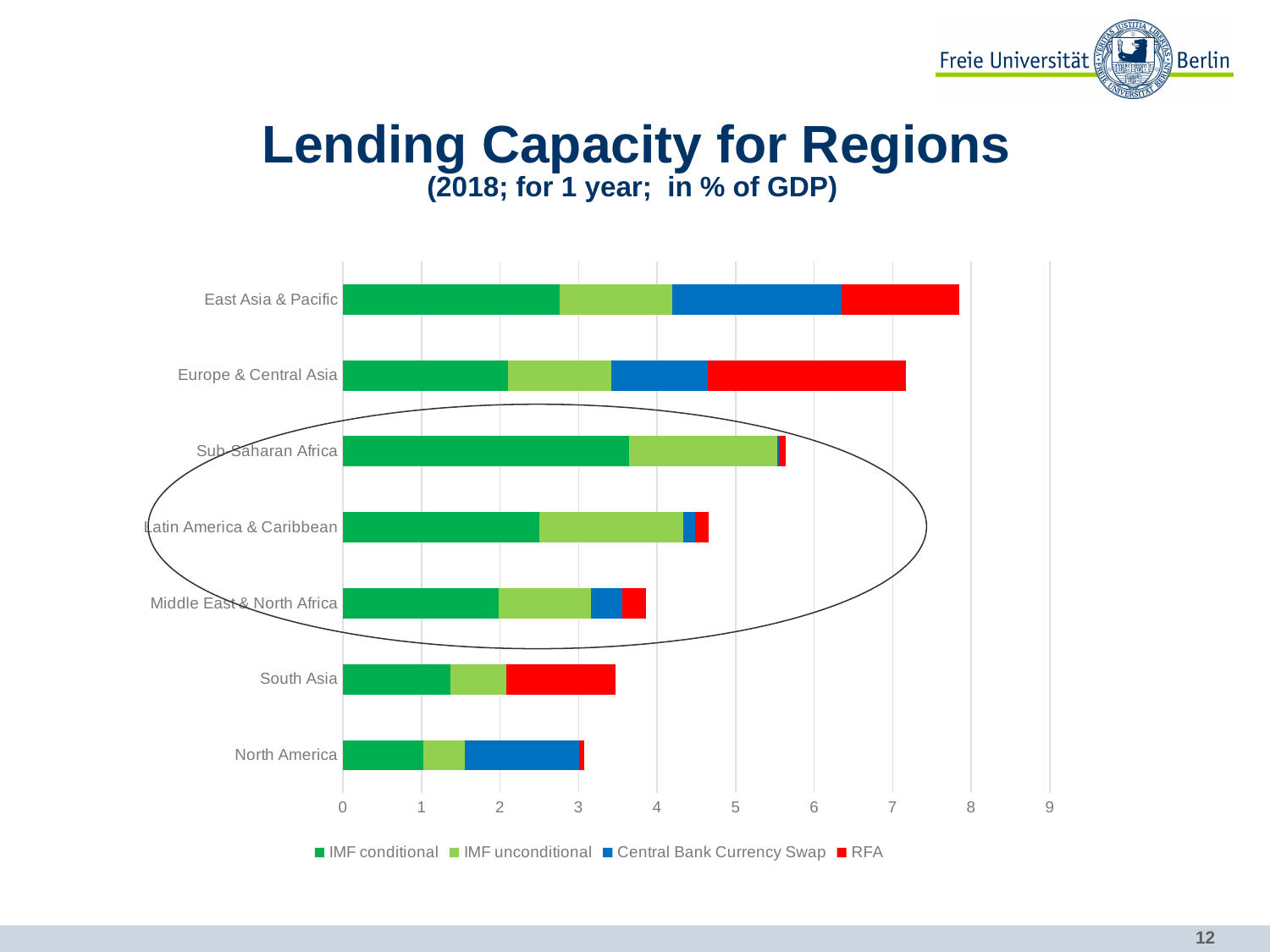
What kind of chart is shown on the slide? Stacked bar chart Do the total bar lengths generally increase or decrease from the top region to the bottom region? decrease Is the total lending capacity for Latin America & Caribbean greater or less than 5? less Is the total lending capacity for East Asia & Pacific greater or less than 7? greater Is the total lending capacity for South Asia greater or less than 4? less Which has a larger total lending capacity, East Asia & Pacific or Europe & Central Asia? East Asia & Pacific Which region has the highest total lending capacity? East Asia & Pacific Which has a larger total lending capacity, Sub-Saharan Africa or Middle East & North Africa? Sub-Saharan Africa Which series is shown in red in the legend? RFA How many regions are plotted in the chart? 7 How many series does the legend list? 4